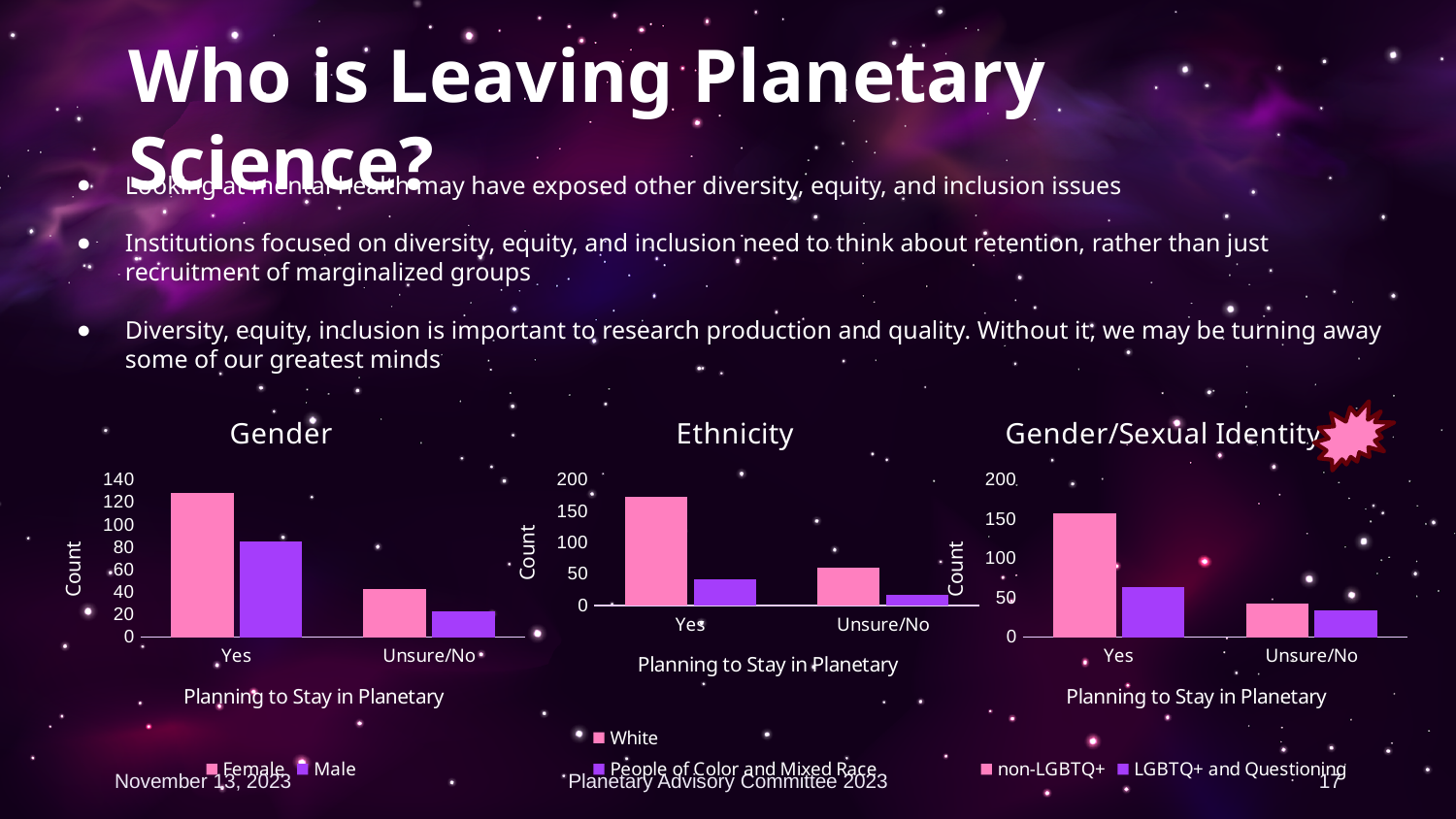
In the Gender chart, how many series does the legend list? 2 In the Gender/Sexual Identity chart, which category has the highest non-LGBTQ+ value? Yes What kind of chart is the Gender chart? bar chart In the Ethnicity chart, how many categories are shown on the x axis? 2 In the Gender chart, is the Male value for Unsure/No greater or less than 40? less In the Ethnicity chart, do the White values rise or fall from Yes to Unsure/No? fall What is the x-axis title of the Gender/Sexual Identity chart? Planning to Stay in Planetary In the Ethnicity chart, is the White value for Yes greater or less than 150? greater In the Ethnicity chart, is the People of Color and Mixed Race value for Yes greater or less than 50? less In the Gender chart, which is larger for Yes, Female or Male? Female